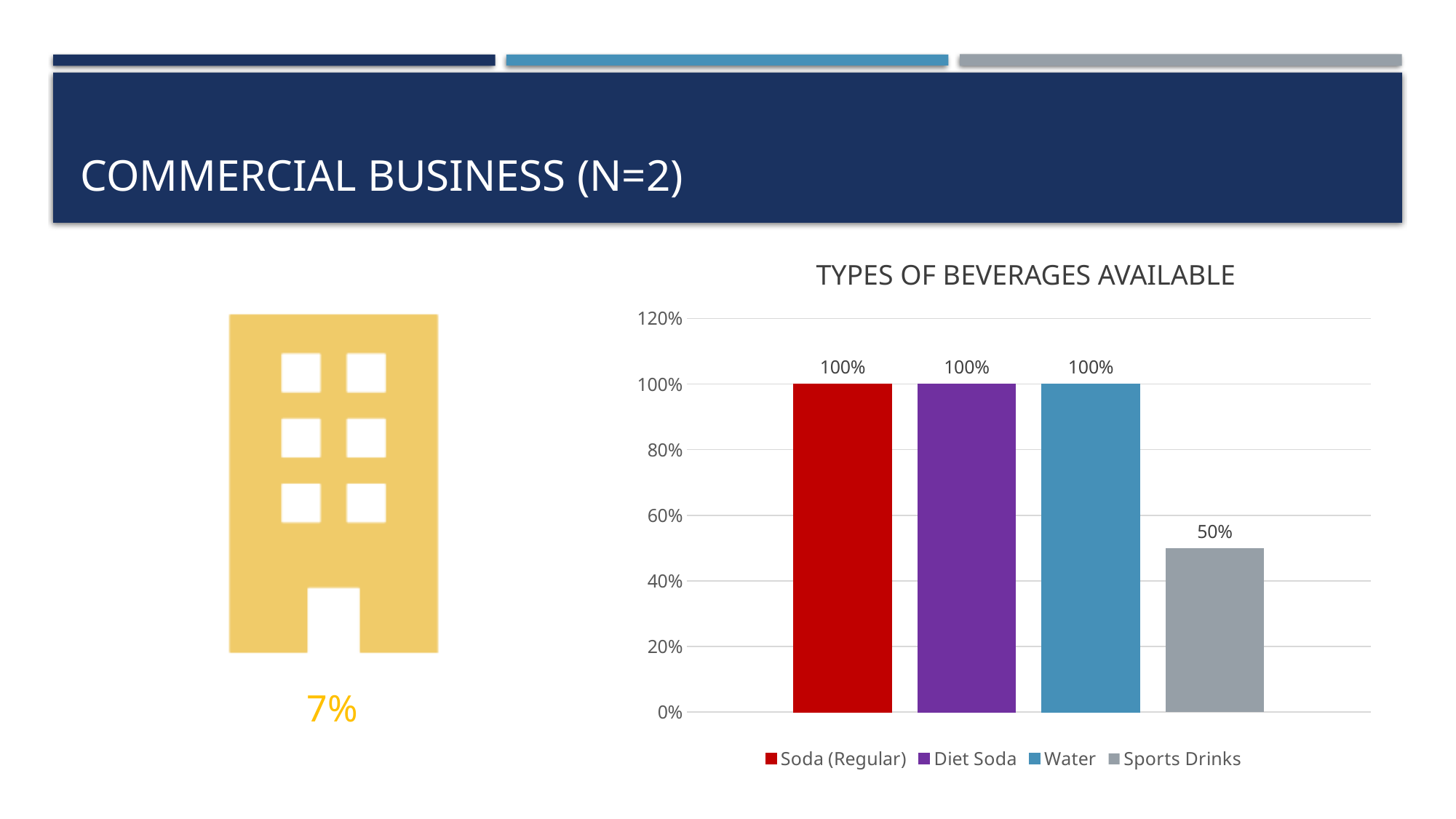
What is the title of the chart on the slide? Types of Beverages Available What colour is the bar for Soda (Regular)? Red Which is larger, the value for Water or the value for Sports Drinks? Water What kind of chart is shown on the slide? Bar chart Which beverage type has the lowest value in the chart? Sports Drinks What is the difference between the values for Soda (Regular) and Sports Drinks? 50% How many entries does the legend of the chart list? 4 How many bars are shown in the Types of Beverages Available chart? 4 Is the value for Sports Drinks greater or less than 80%? less What is the value for Sports Drinks in the Types of Beverages Available chart? 50% What is the value for Water in the Types of Beverages Available chart? 100% What is the value for Diet Soda in the Types of Beverages Available chart? 100%